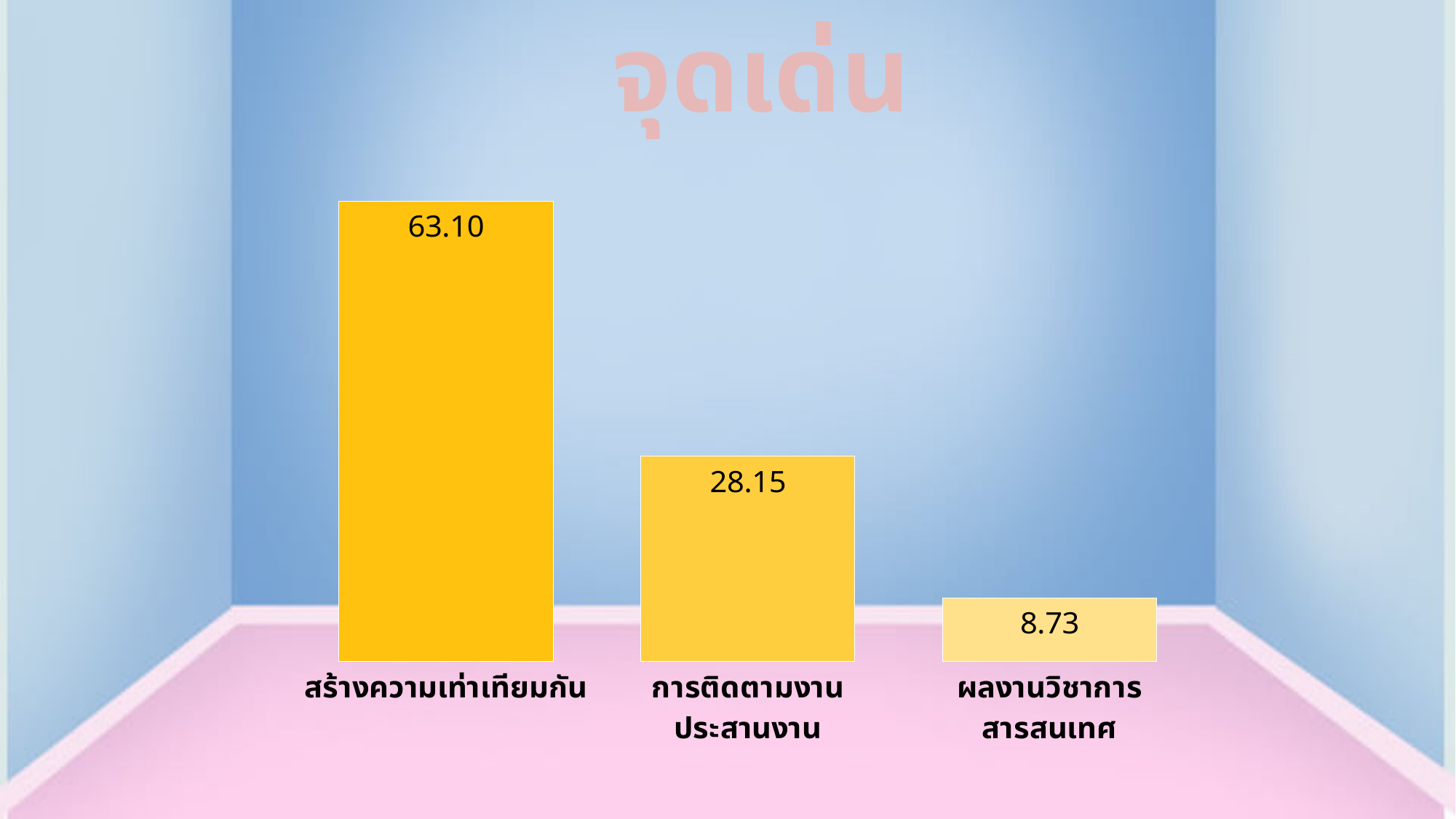
Which category has the highest value? สร้างความเท่าเทียมกัน How many categories are shown in the chart? 3 What value is shown for การติดตามงานประสานงาน? 28.15 What is the difference between the values for การติดตามงานประสานงาน and ผลงานวิชาการสารสนเทศ? 19.42 What value is shown for ผลงานวิชาการสารสนเทศ? 8.73 What is the title shown above the chart? จุดเด่น Which is larger, the value for การติดตามงานประสานงาน or the value for ผลงานวิชาการสารสนเทศ? การติดตามงานประสานงาน Do the values rise or fall from left to right across the categories? Fall Which category has the lowest value? ผลงานวิชาการสารสนเทศ What kind of chart is shown on the slide? Bar chart What is the difference between the values for สร้างความเท่าเทียมกัน and การติดตามงานประสานงาน? 34.95 What value is shown for สร้างความเท่าเทียมกัน? 63.10